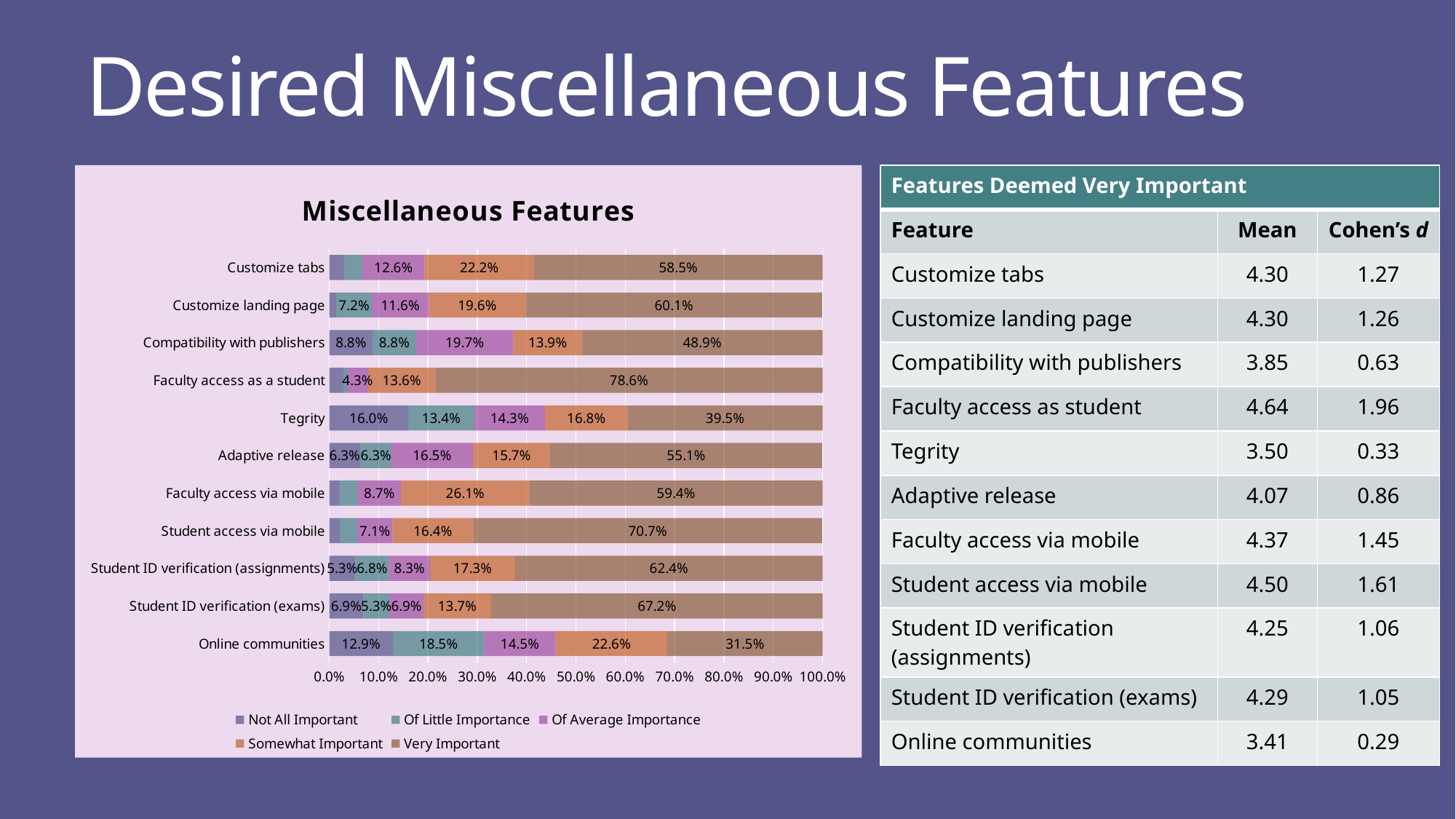
In the Miscellaneous Features chart, what is the Very Important value for Faculty access as a student? 78.6% What kind of chart is the Miscellaneous Features chart? Stacked bar chart In the Miscellaneous Features chart, what is the difference between the Not All Important values for Tegrity and Online communities? 3.1 percentage points In the Miscellaneous Features chart, what is the Of Average Importance value for Compatibility with publishers? 19.7% In the Miscellaneous Features chart, what is the Of Little Importance value for Online communities? 18.5% In the Miscellaneous Features chart, which feature has the highest Very Important value? Faculty access as a student How many series does the legend of the Miscellaneous Features chart list? 5 How many features are listed on the y axis of the Miscellaneous Features chart? 11 In the Miscellaneous Features chart, which has the larger Very Important value: Student access via mobile or Student ID verification (exams)? Student access via mobile In the Miscellaneous Features chart, which feature has the lowest Very Important value? Online communities In the Miscellaneous Features chart, what is the Somewhat Important value for Customize tabs? 22.2% In the Miscellaneous Features chart, is the Not All Important value for Customize tabs greater or less than 10.0%? less